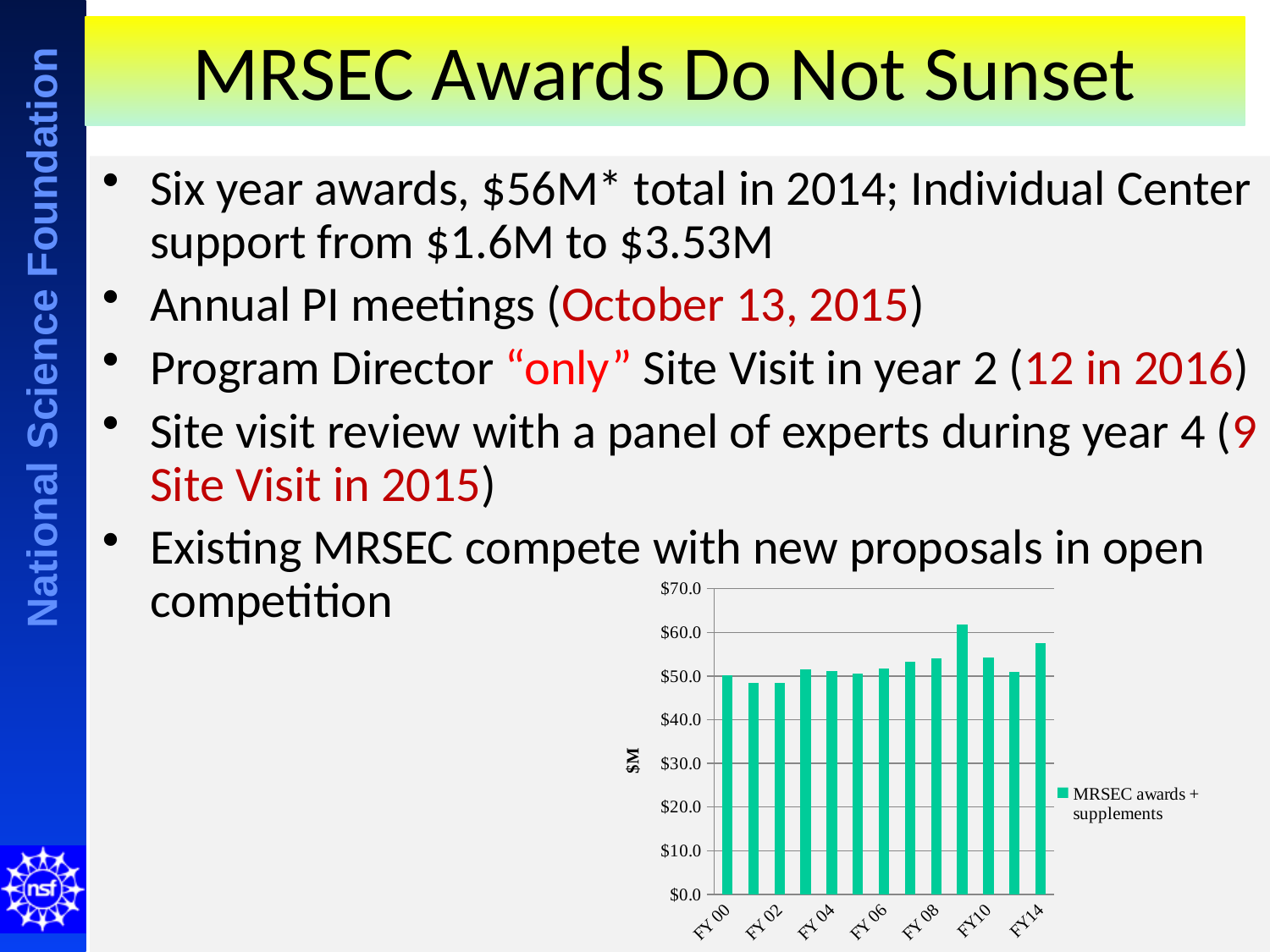
Is the value for FY 02 greater or less than $50.0? less Is the value for FY 00 greater or less than $60.0? less Which is larger, the value for FY 02 or the value for FY 08? FY 08 How many bars are plotted in the chart? 13 Which is larger, the value for FY 10 or the value for FY 14? FY 14 What is the name of the series shown in the chart legend? MRSEC awards + supplements Is the value for FY 10 greater or less than $50.0? greater How many series does the chart legend list? 1 What kind of chart is shown on the slide? bar chart What is the label on the vertical axis of the chart? $M